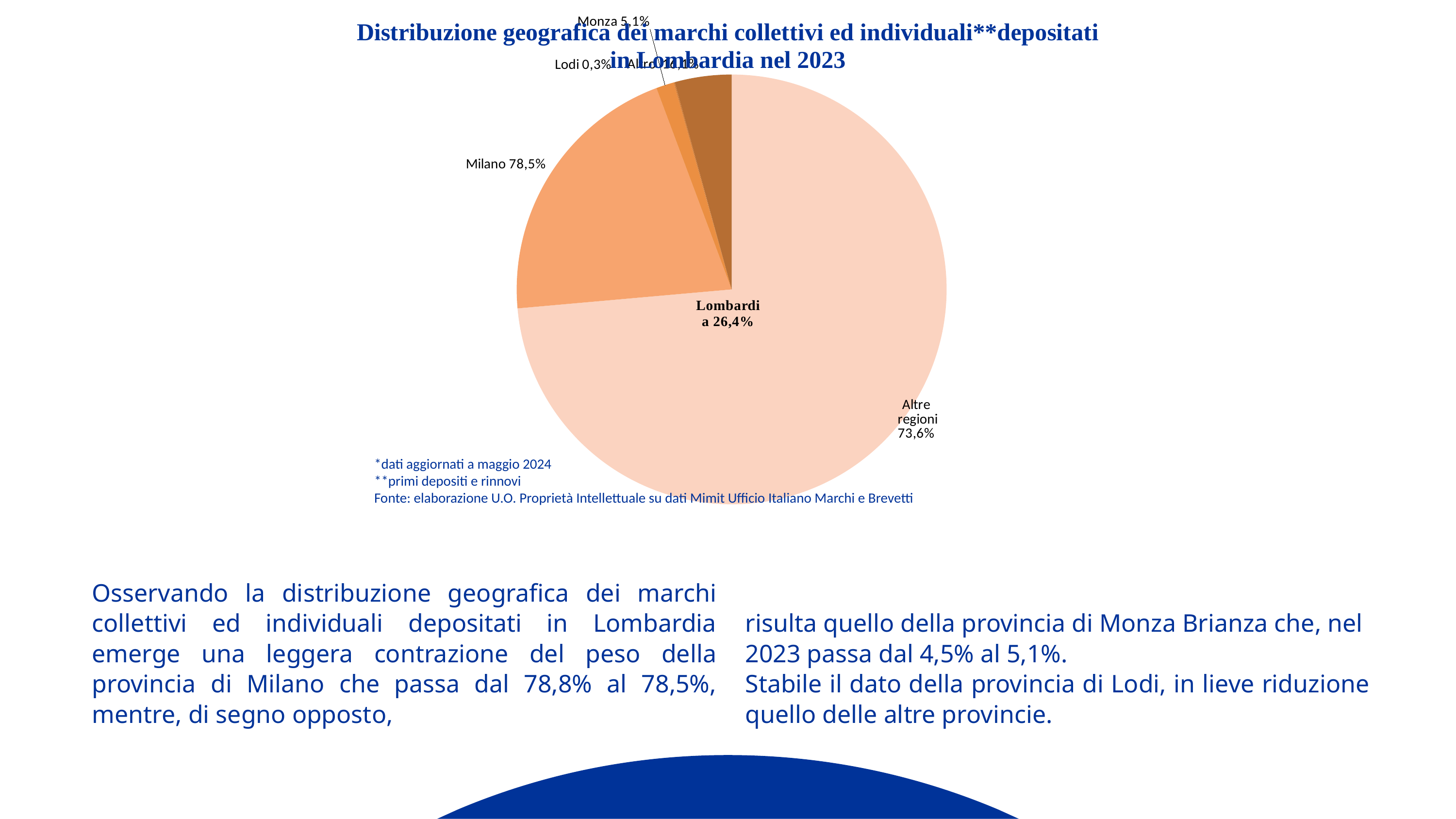
What kind of chart is shown on the slide? pie chart Which has the larger share, Monza or Lodi? Monza What share of the trademarks filed in Lombardia is attributed to Milano? 78,5% What share is shown for Lombardia in the chart? 26,4% Which province has the largest share in the chart? Milano What share is shown for Monza? 5,1% By how many percentage points does Milano's share exceed Monza's share? 73,4 Which labelled province has the smallest share in the chart? Lodi What share is shown for Lodi? 0,3% Which has the larger share, Lombardia or Altre regioni? Altre regioni What share is shown for Altre regioni? 73,6% By how many percentage points does the share of Altre regioni exceed that of Lombardia? 47,2